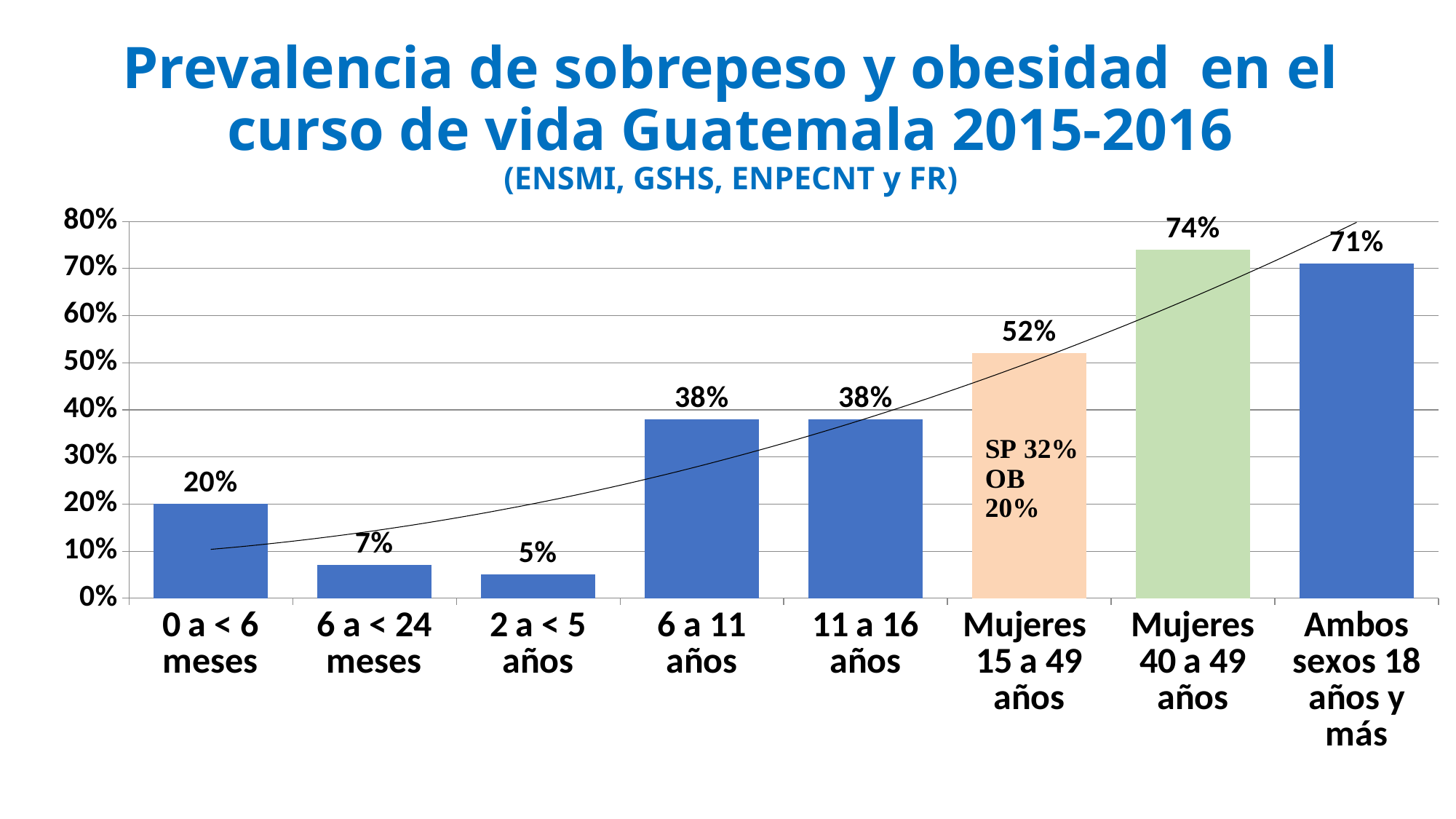
What is the difference between the values for "Mujeres 40 a 49 años" and "Ambos sexos 18 años y más"? 3% How many categories are shown on the x axis? 8 Which category has the lowest value? 2 a < 5 años What is the value for the "6 a 11 años" category? 38% What is the difference between the values for "6 a < 24 meses" and "2 a < 5 años"? 2% What is the value for the "0 a < 6 meses" category? 20% Which is larger, the value for "Mujeres 15 a 49 años" or the value for "11 a 16 años"? Mujeres 15 a 49 años What colour is the bar for "Mujeres 40 a 49 años"? Green What is the value for the "Mujeres 15 a 49 años" category? 52% Which category has the highest value? Mujeres 40 a 49 años What is the SP (sobrepeso) value shown inside the "Mujeres 15 a 49 años" bar? 32% What kind of chart is this? Bar chart